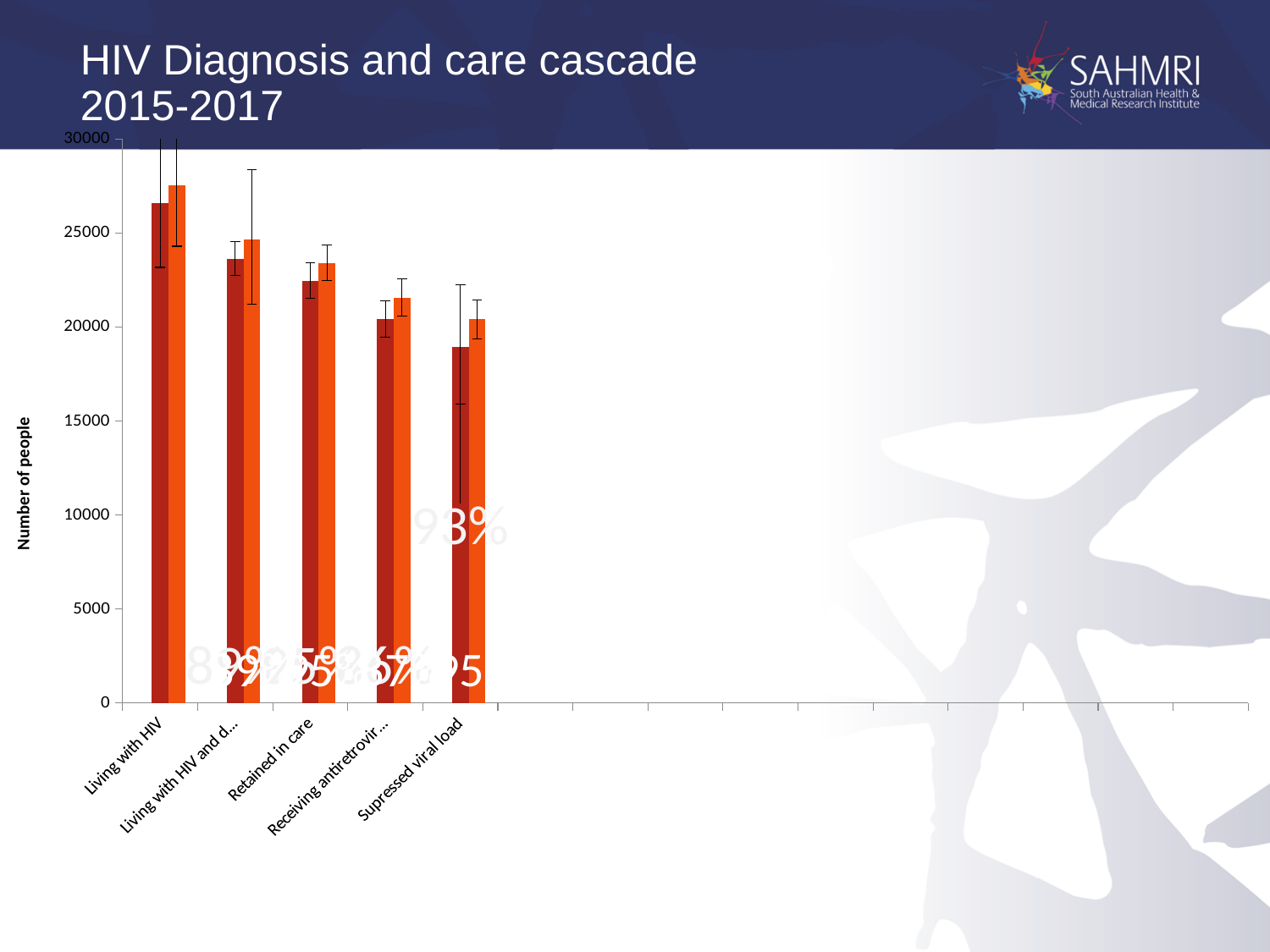
Is the value of the dark red bar for Supressed viral load greater or less than 20000? less Which category has the highest bars in the chart? Living with HIV Which category has the lowest bars in the chart? Supressed viral load Is the value of the dark red bar for Retained in care greater or less than 25000? less How many categories are shown along the x axis of the chart? 5 What kind of chart is shown on the slide? bar chart How many bars are plotted for each category in the chart? 2 Which category has larger bars, Living with HIV or Supressed viral load? Living with HIV Is the value of the dark red bar for Living with HIV greater or less than 25000? greater Do the bar values rise or fall moving from left to right along the x axis? fall What is the title of the y axis of the chart? Number of people For Supressed viral load, which bar is taller, the dark red bar or the orange bar? the orange bar